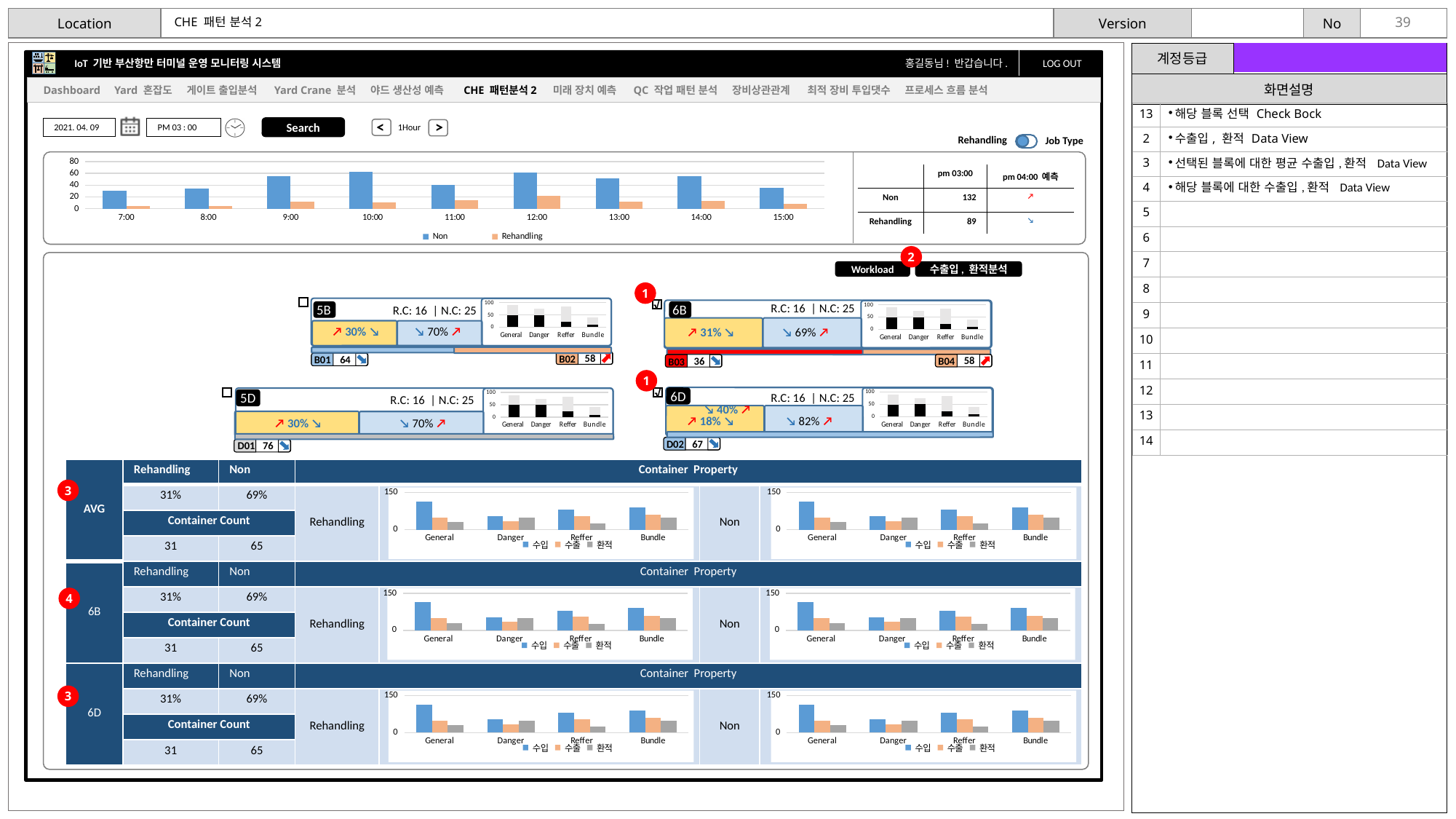
What are the two legend entries of the top chart? Non, Rehandling In the AVG row's Rehandling Container Property chart, how many series does the legend list? 3 In the AVG row's Rehandling Container Property chart, how many categories are on the x axis? 4 In the top chart, is the Non value at 9:00 greater or less than 40? greater In the top bar chart, how many time points are shown on the x axis? 9 In the top chart, which is larger, the Non value at 9:00 or the Non value at 7:00? 9:00 What kind of chart is the top chart showing Non and Rehandling by hour? bar chart In the top chart, is the Non value at 7:00 greater or less than 40? less How many series does the legend of the top chart list? 2 In the top chart, which is larger at 12:00, Non or Rehandling? Non In the top chart, at which hour is the Rehandling value highest? 12:00 In the top chart, is the Rehandling value at 7:00 greater or less than 20? less